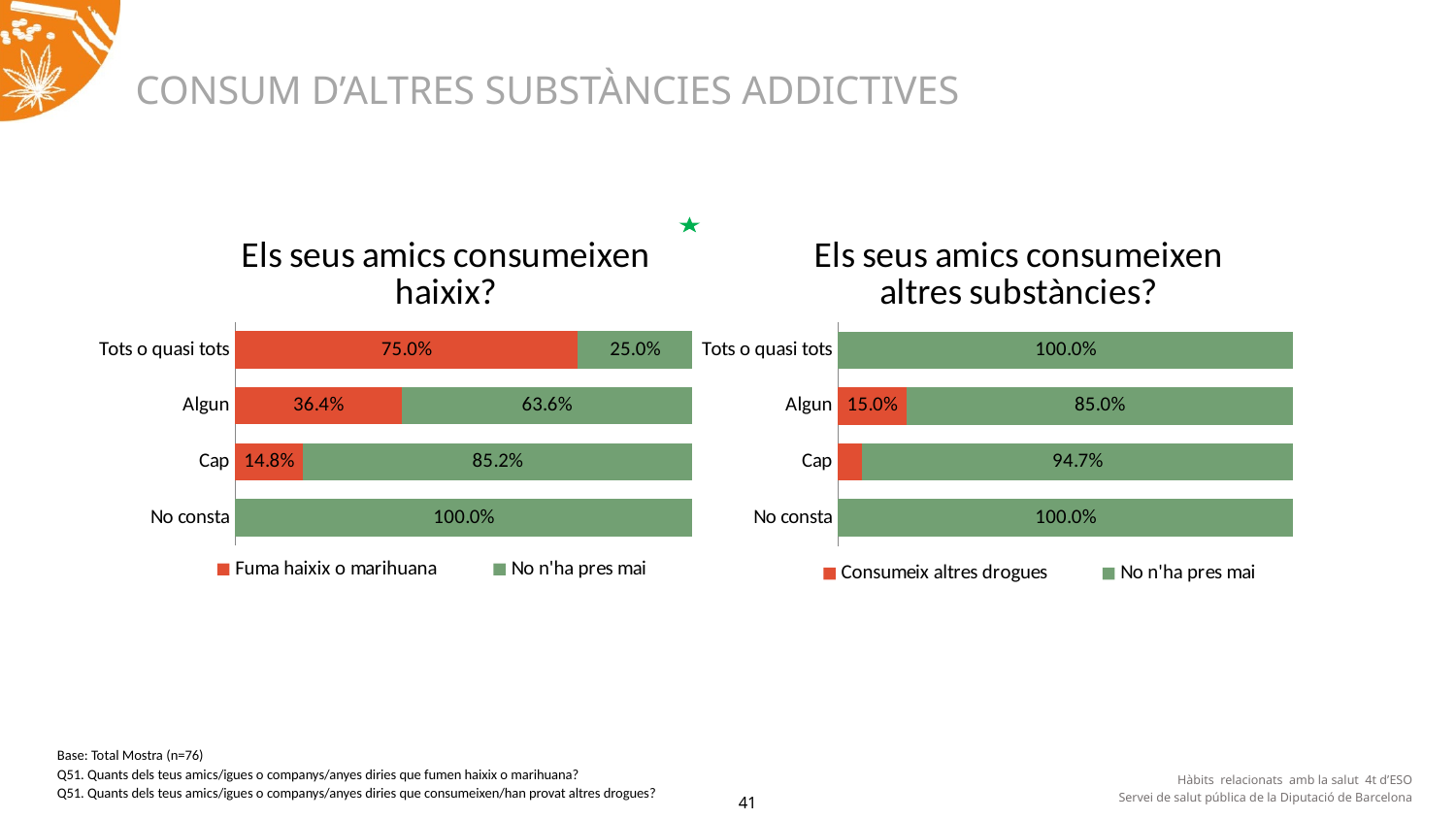
In the chart 'Els seus amics consumeixen haixix?', what is the value of 'Fuma haixix o marihuana' for 'Tots o quasi tots'? 75.0% In the chart 'Els seus amics consumeixen haixix?', which category has the highest value for 'Fuma haixix o marihuana'? Tots o quasi tots What are the legend entries of the chart 'Els seus amics consumeixen altres substàncies?'? Consumeix altres drogues; No n'ha pres mai How many categories are shown on the y axis of the chart 'Els seus amics consumeixen haixix?'? 4 In the chart 'Els seus amics consumeixen haixix?', what is the value of 'No n'ha pres mai' for 'Algun'? 63.6% How many series does the legend of the chart 'Els seus amics consumeixen altres substàncies?' list? 2 What type of chart is 'Els seus amics consumeixen haixix?'? Stacked bar chart In the chart 'Els seus amics consumeixen haixix?', what is the value of 'Fuma haixix o marihuana' for 'Cap'? 14.8% In the chart 'Els seus amics consumeixen haixix?', what is the difference between the 'Fuma haixix o marihuana' values for 'Tots o quasi tots' and 'Algun'? 38.6% In the chart 'Els seus amics consumeixen altres substàncies?', which is larger: 'No n'ha pres mai' for 'Algun' or for 'Cap'? Cap In the chart 'Els seus amics consumeixen altres substàncies?', what is the value of 'No n'ha pres mai' for 'Cap'? 94.7% In the chart 'Els seus amics consumeixen altres substàncies?', what is the value of 'Consumeix altres drogues' for 'Algun'? 15.0%